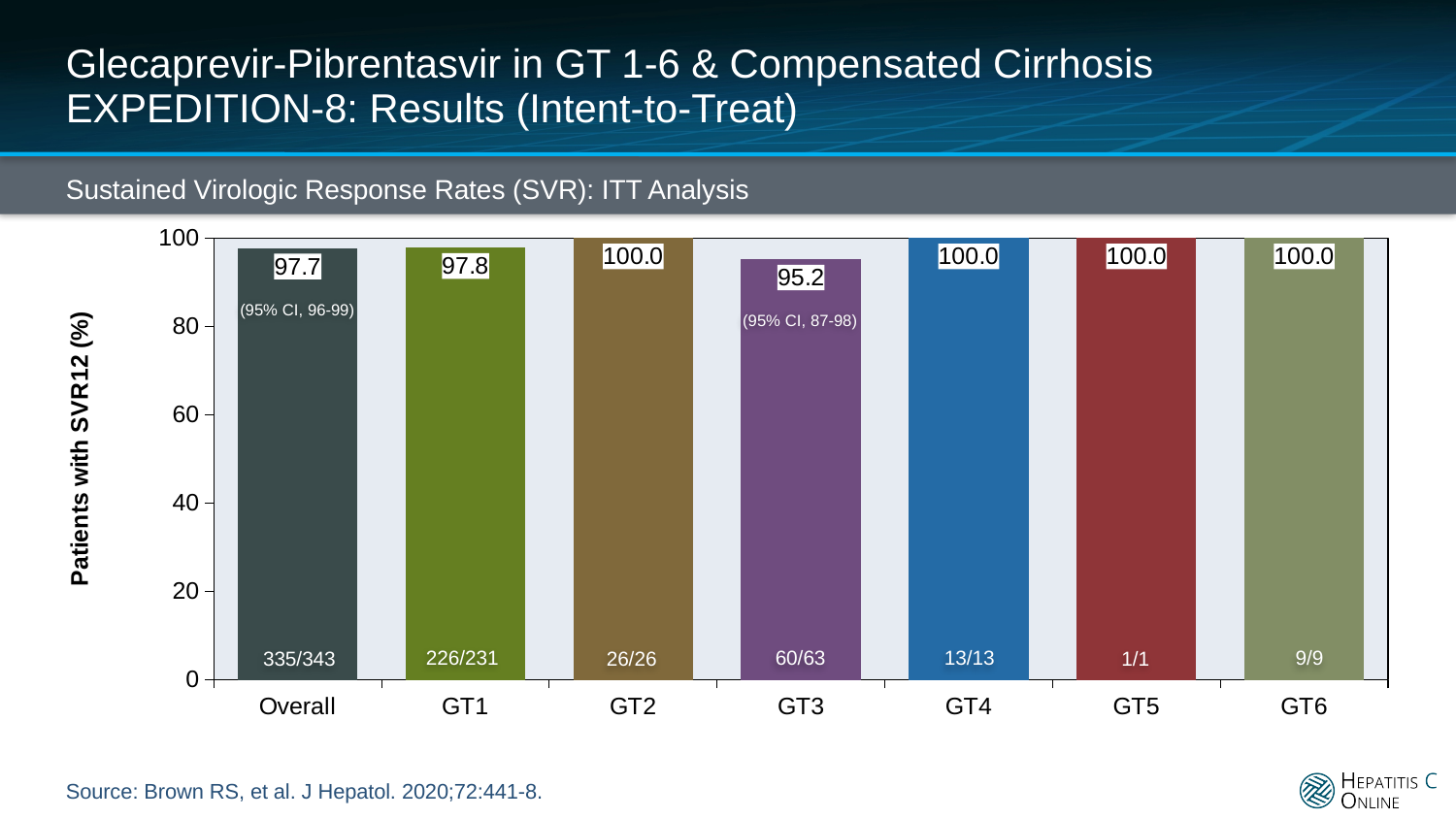
What is the 95% CI shown for GT3? 87-98 What kind of chart is shown? Bar chart What is the SVR12 rate for GT1? 97.8 What is the SVR12 rate for GT3? 95.2 What is the difference in SVR12 rate between GT2 and GT3? 4.8 What fraction of patients is shown for the Overall group? 335/343 What is the SVR12 rate for the Overall group? 97.7 What fraction of patients is shown for GT1? 226/231 Which has a higher SVR12 rate, GT1 or GT3? GT1 What is the y-axis label of the chart? Patients with SVR12 (%) How many categories are shown on the x axis? 7 Which category has the lowest SVR12 rate? GT3